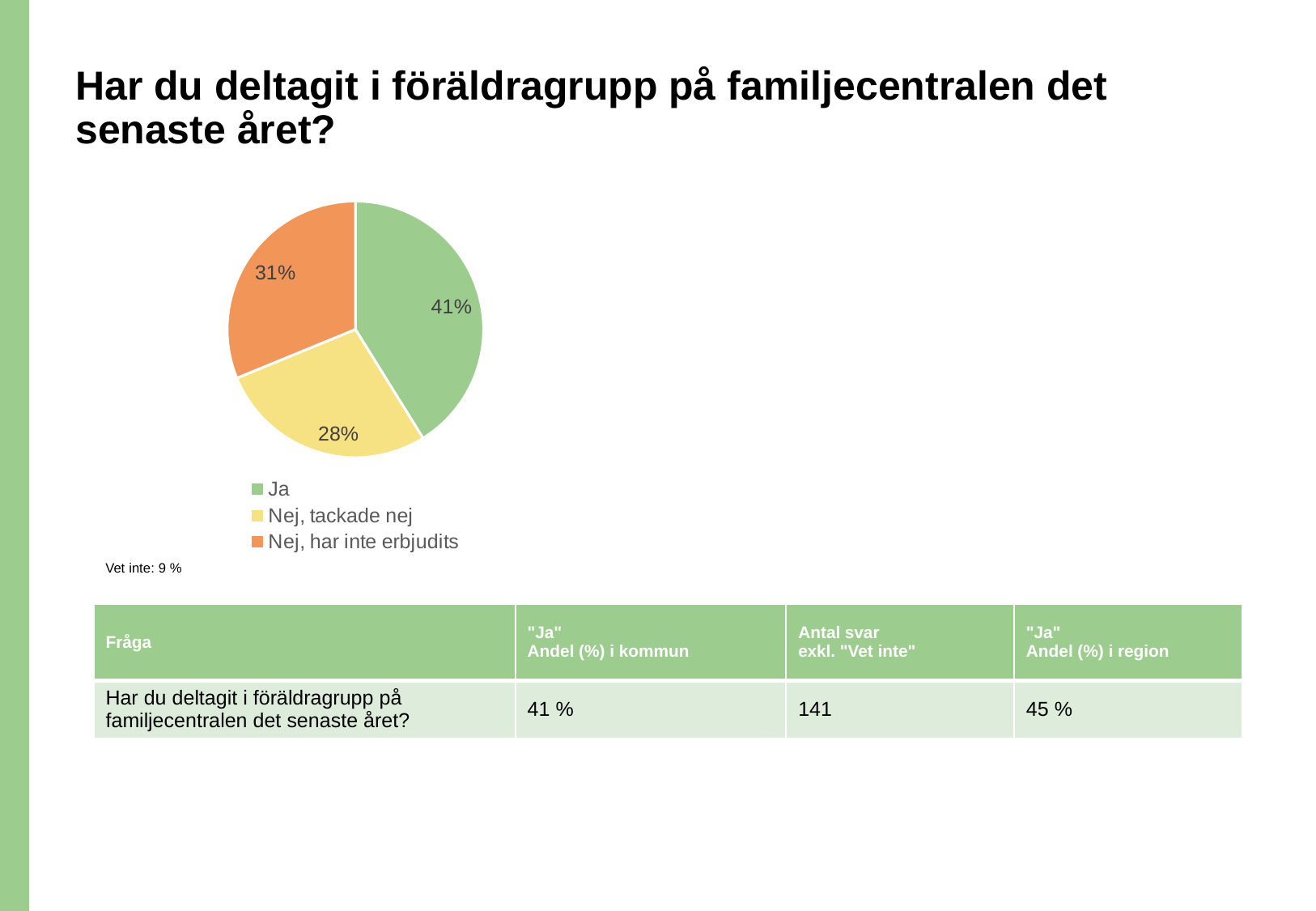
Which slice of the pie is the smallest? Nej, tackade nej What is the difference in percentage points between the "Ja" slice and the "Nej, tackade nej" slice? 13 What colour is the "Nej, har inte erbjudits" slice in the pie chart? Orange Which is larger: the "Nej, har inte erbjudits" slice or the "Nej, tackade nej" slice? Nej, har inte erbjudits What type of chart is shown on the slide? Pie chart What share of the pie does "Nej, tackade nej" represent? 28% Which slice of the pie is the largest? Ja How many slices does the pie chart have? 3 What colour is the "Ja" slice in the pie chart? Green What share of the pie does "Ja" represent? 41% What share of the pie does "Nej, har inte erbjudits" represent? 31% How many entries does the legend list? 3